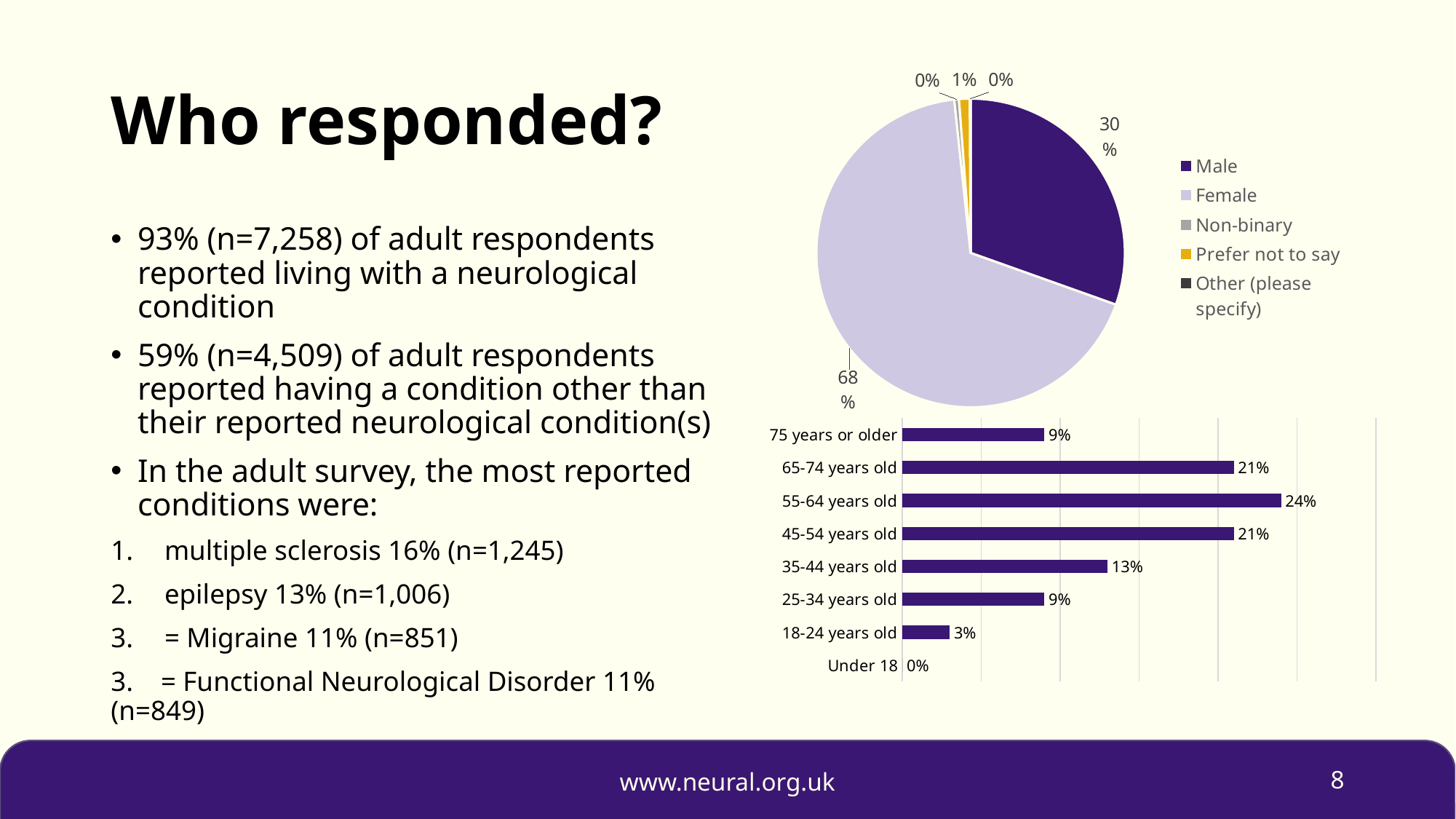
In the pie chart at the top right, which category has the largest share? Female In the bar chart at the bottom right, which is larger: the value for 65-74 years old or 75 years or older? 65-74 years old In the bar chart at the bottom right, what is the value for 55-64 years old? 24% In the bar chart at the bottom right, what is the value for 18-24 years old? 3% In the pie chart at the top right, what share of respondents were Male? 30% In the bar chart at the bottom right, what is the difference between the values for 55-64 years old and 35-44 years old? 11% In the pie chart at the top right, what share of respondents chose 'Prefer not to say'? 1% In the bar chart at the bottom right, which age group has the highest value? 55-64 years old How many age categories are shown in the bar chart at the bottom right? 8 How many entries does the legend of the pie chart at the top right list? 5 In the bar chart at the bottom right, which age group has the lowest value? Under 18 In the pie chart at the top right, what share of respondents were Female? 68%